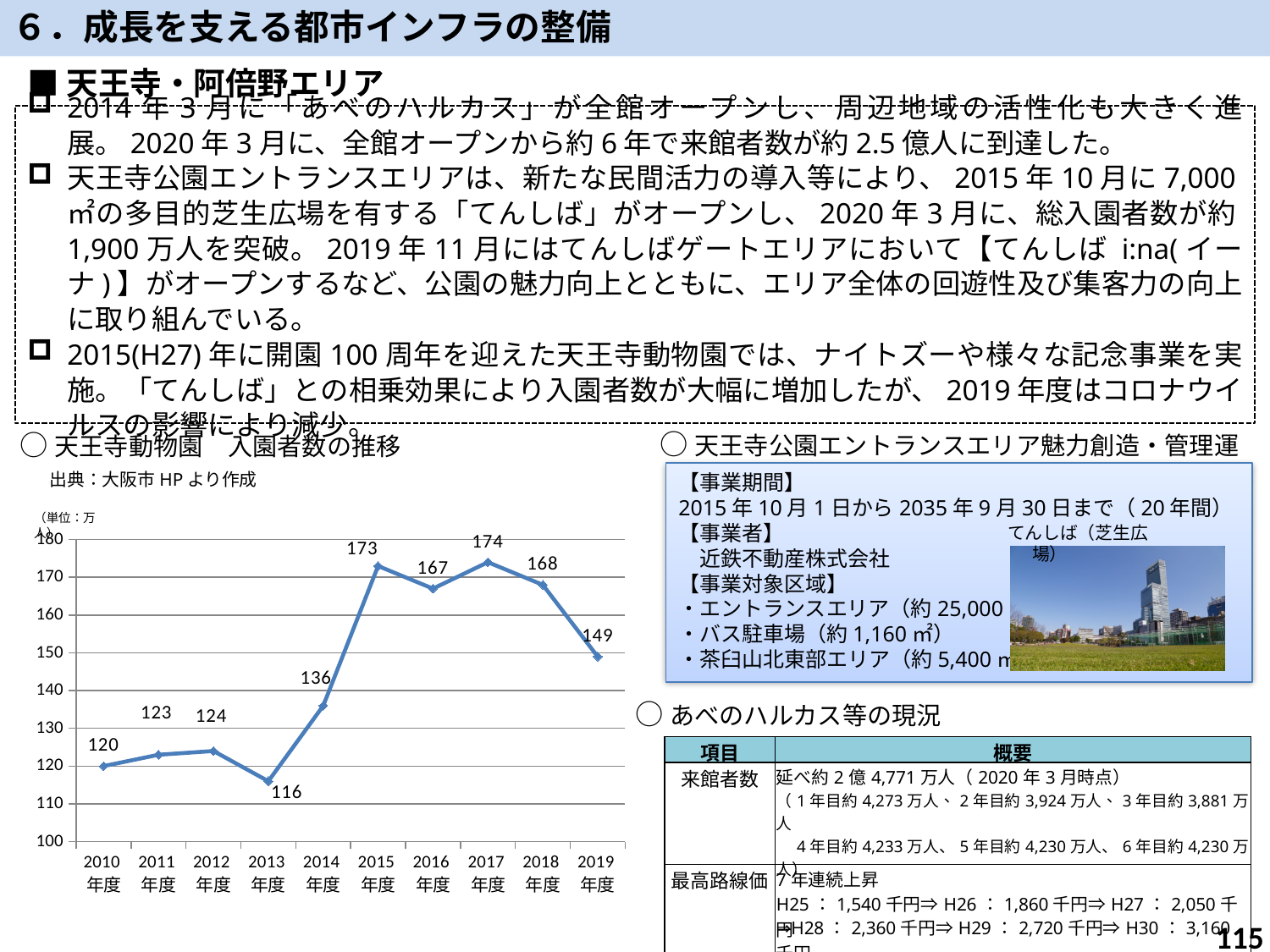
In the 天王寺動物園 入園者数の推移 chart, which is larger, the value for 2016年度 or 2018年度? 2018年度 What unit is shown for the values in the 天王寺動物園 入園者数の推移 chart? 万人 How many years are plotted in the 天王寺動物園 入園者数の推移 chart? 10 In the 天王寺動物園 入園者数の推移 chart, does the value rise or fall from 2018年度 to 2019年度? fall In the 天王寺動物園 入園者数の推移 chart, what is the value for 2013年度? 116 What type of chart is used to show the 天王寺動物園 入園者数の推移? line chart In the 天王寺動物園 入園者数の推移 chart, is the value for 2014年度 greater or less than 130? greater In the 天王寺動物園 入園者数の推移 chart, what is the value for 2015年度? 173 In the 天王寺動物園 入園者数の推移 chart, what is the value for 2019年度? 149 In the 天王寺動物園 入園者数の推移 chart, what is the difference between the values for 2015年度 and 2014年度? 37 In the 天王寺動物園 入園者数の推移 chart, which year has the highest value? 2017年度 In the 天王寺動物園 入園者数の推移 chart, which year has the lowest value? 2013年度